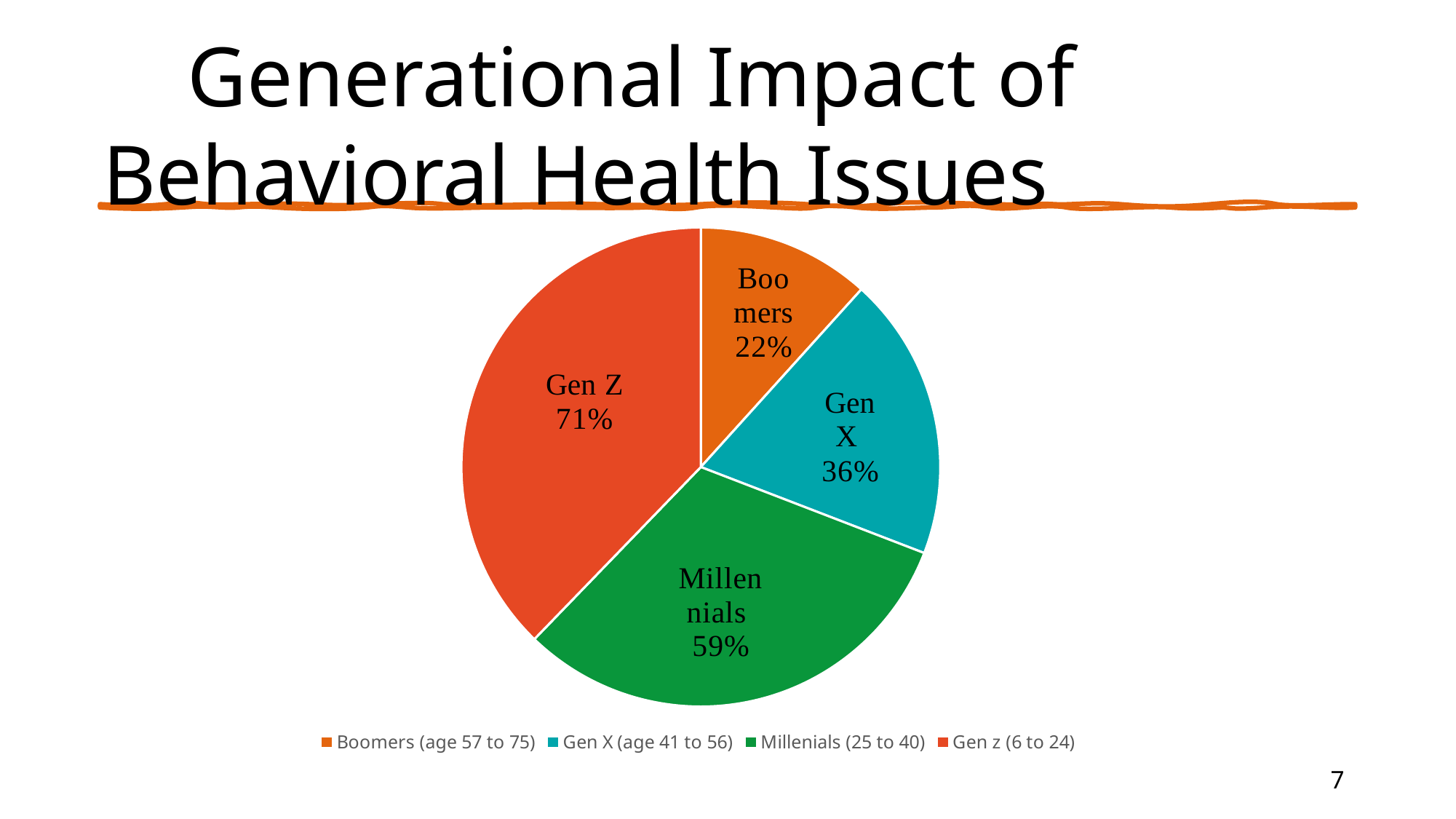
Which generation has the largest slice of the pie chart? Gen Z Which is larger, the value for Millennials or the value for Gen X? Millennials How many generations are shown in the pie chart? 4 Which generation has the smallest slice of the pie chart? Boomers What is the difference between the values shown for Gen Z and Boomers? 49 percentage points What colour is the Millennials slice in the pie chart? Green What kind of chart is shown on the slide? Pie chart What value is shown for Millennials on the pie chart? 59% What value is shown for Boomers on the pie chart? 22% According to the legend, what age range is given for Gen X? age 41 to 56 What value is shown for Gen X on the pie chart? 36% What value is shown for Gen Z on the pie chart? 71%